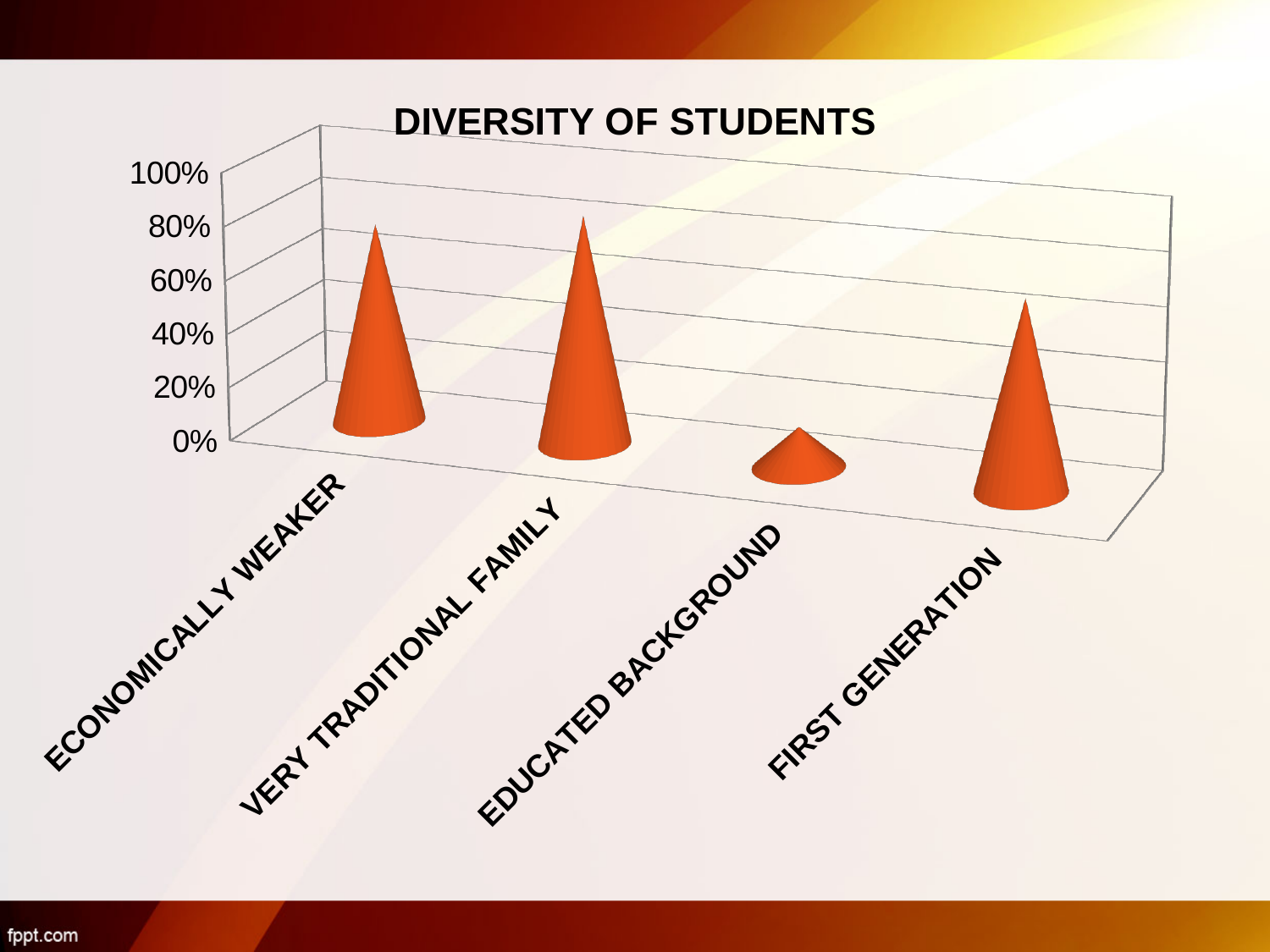
What is the highest value shown on the vertical axis? 100% Which is larger, the value for FIRST GENERATION or the value for EDUCATED BACKGROUND? FIRST GENERATION Is the value for FIRST GENERATION greater or less than 40%? greater Which category has the lowest value? EDUCATED BACKGROUND What kind of chart is shown on the slide? bar chart Is the value for ECONOMICALLY WEAKER greater or less than 60%? greater Is the value for FIRST GENERATION greater or less than 80%? less How many categories are plotted in the chart? 4 Which is larger, the value for VERY TRADITIONAL FAMILY or the value for FIRST GENERATION? VERY TRADITIONAL FAMILY What is the title of the chart? DIVERSITY OF STUDENTS